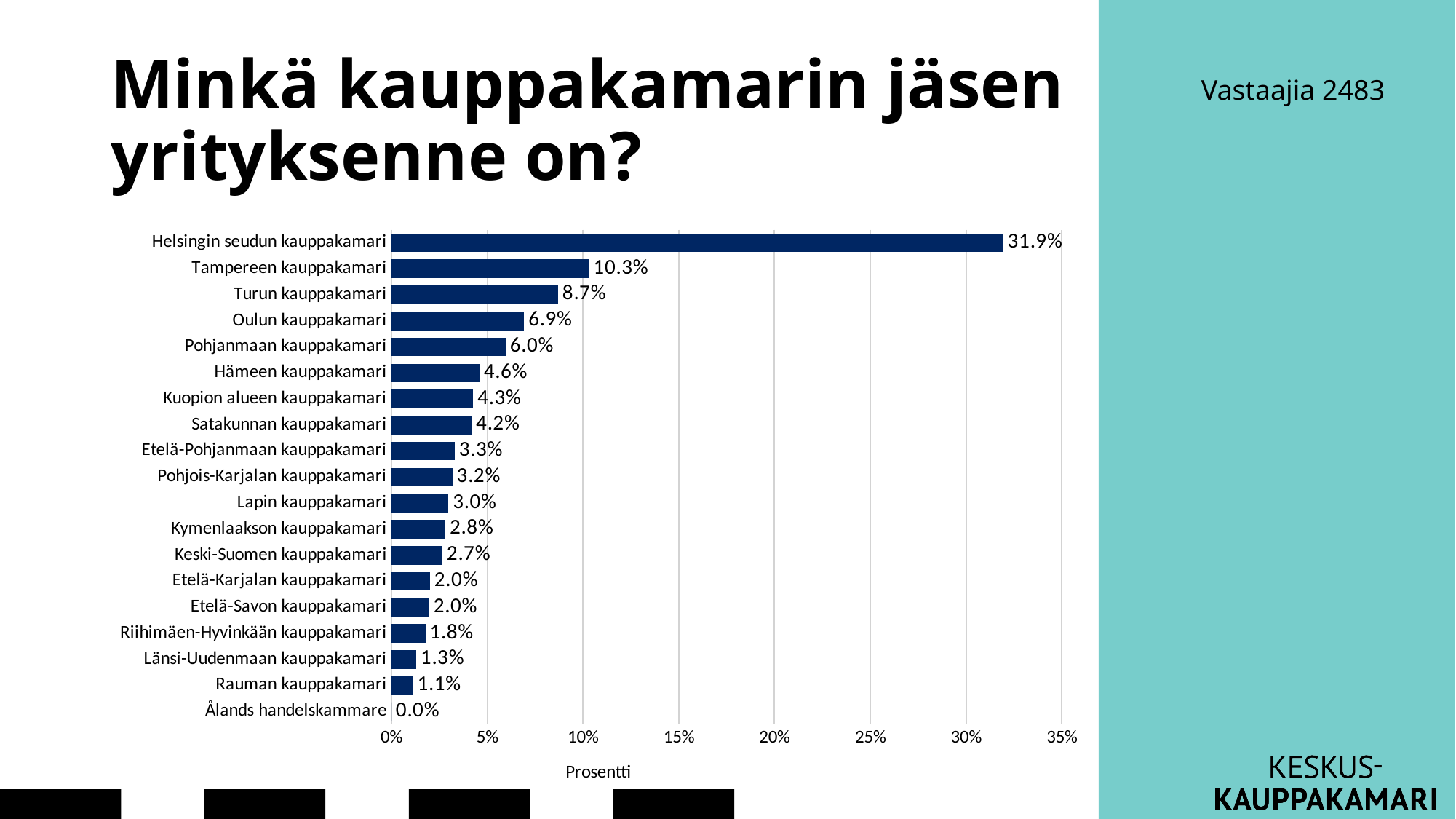
Which is larger, the value for Hämeen kauppakamari or the value for Keski-Suomen kauppakamari? Hämeen kauppakamari What is the difference between the values for Helsingin seudun kauppakamari and Tampereen kauppakamari? 21.6% What is the value for Lapin kauppakamari? 3.0% Which category has the highest value? Helsingin seudun kauppakamari What is the difference between the values for Turun kauppakamari and Oulun kauppakamari? 1.8% How many categories are shown in the chart? 19 Which category has the lowest value? Ålands handelskammare What is the value for Ålands handelskammare? 0.0% What kind of chart is shown on the slide? bar chart Is the value for Helsingin seudun kauppakamari greater or less than 30%? greater What is the value for Pohjanmaan kauppakamari? 6.0% What is the value for Tampereen kauppakamari? 10.3%